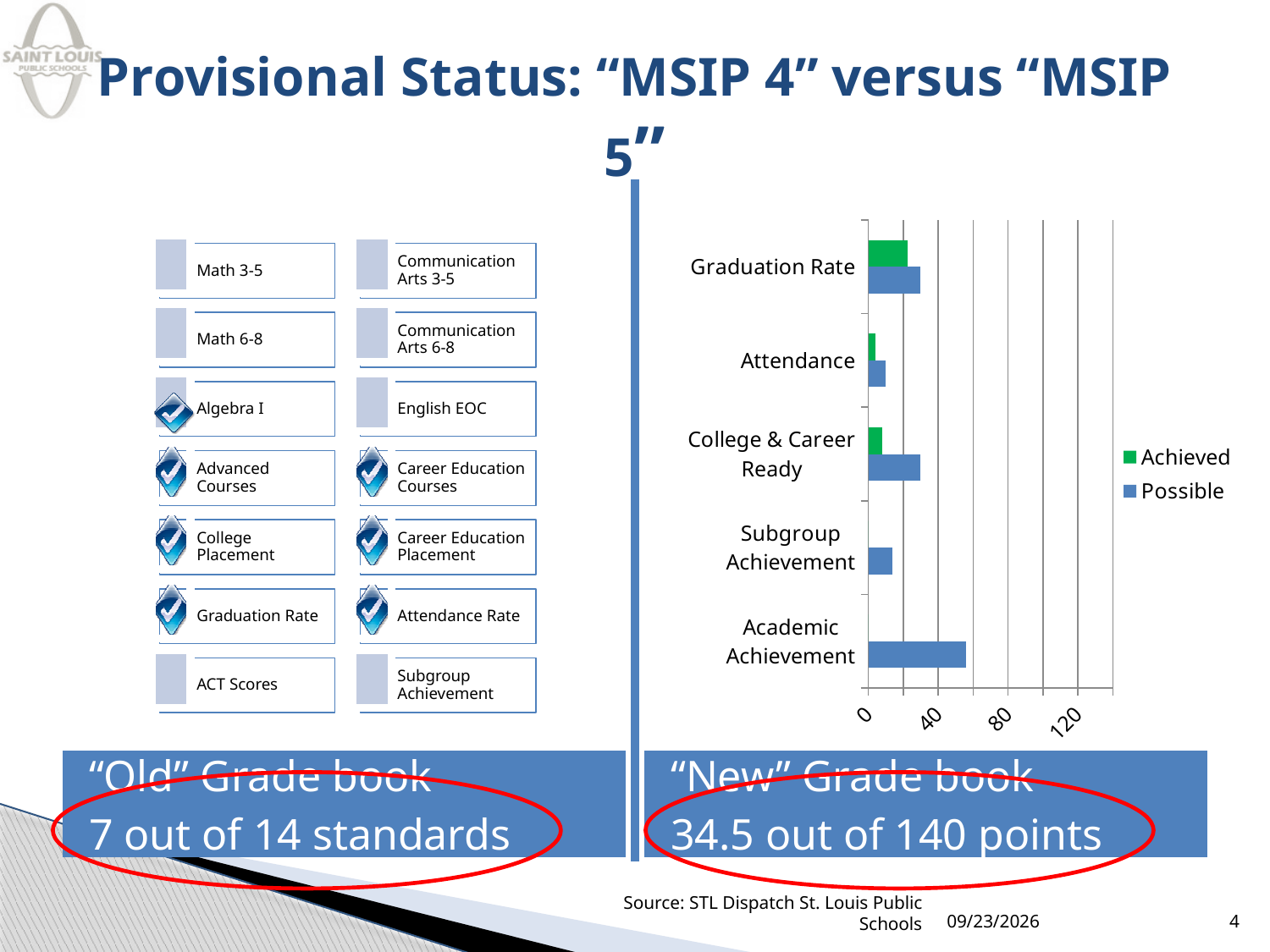
How many series does the chart's legend list? 2 How many categories are plotted on the chart? 5 Is the Achieved value for Attendance greater or less than 40? less Is the Possible value for Academic Achievement greater or less than 40? greater Which category has the highest Possible value? Academic Achievement Which is larger, the Achieved value for Graduation Rate or the Achieved value for College & Career Ready? Graduation Rate What kind of chart is shown on the slide? bar chart What colour represents the Achieved series in the chart's legend? green Is the Possible value for Graduation Rate greater or less than 40? less Which is larger, the Possible value for Academic Achievement or the Possible value for Subgroup Achievement? Academic Achievement Which category has the highest Achieved value? Graduation Rate What are the two series named in the chart's legend? Achieved and Possible